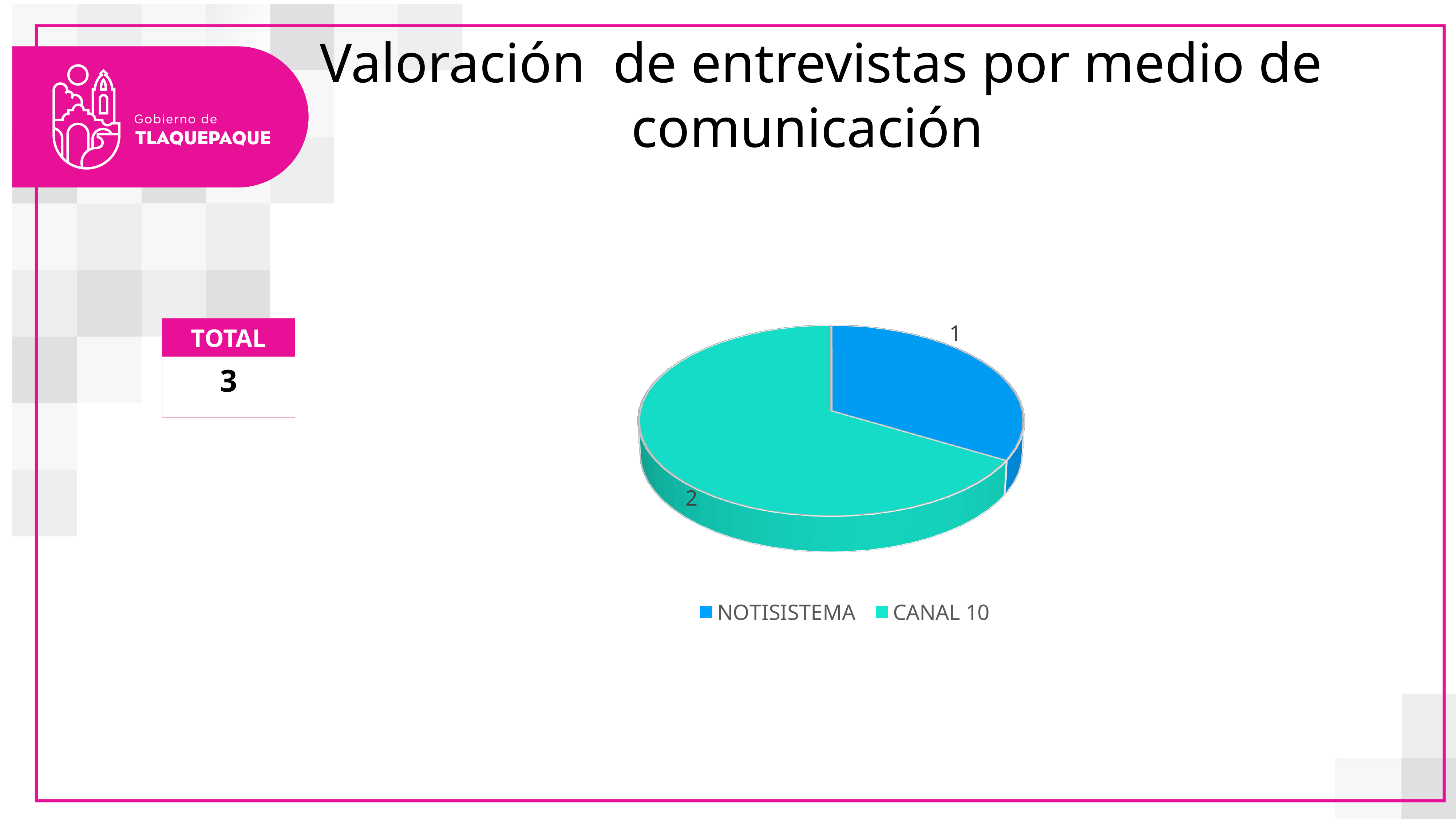
Which medium has the largest slice of the pie? CANAL 10 What is the difference between the values for CANAL 10 and NOTISISTEMA? 1 Which is larger, the value for NOTISISTEMA or the value for CANAL 10? CANAL 10 What share of the pie does CANAL 10 represent? 2 of 3 What is the total of all slices in the pie chart? 3 How many entries does the legend list? 2 What colour is the NOTISISTEMA slice? Blue What type of chart is shown on the slide? Pie chart What is the value for CANAL 10? 2 Which medium has the smallest slice of the pie? NOTISISTEMA What is the value for NOTISISTEMA? 1 How many slices does the pie chart have? 2